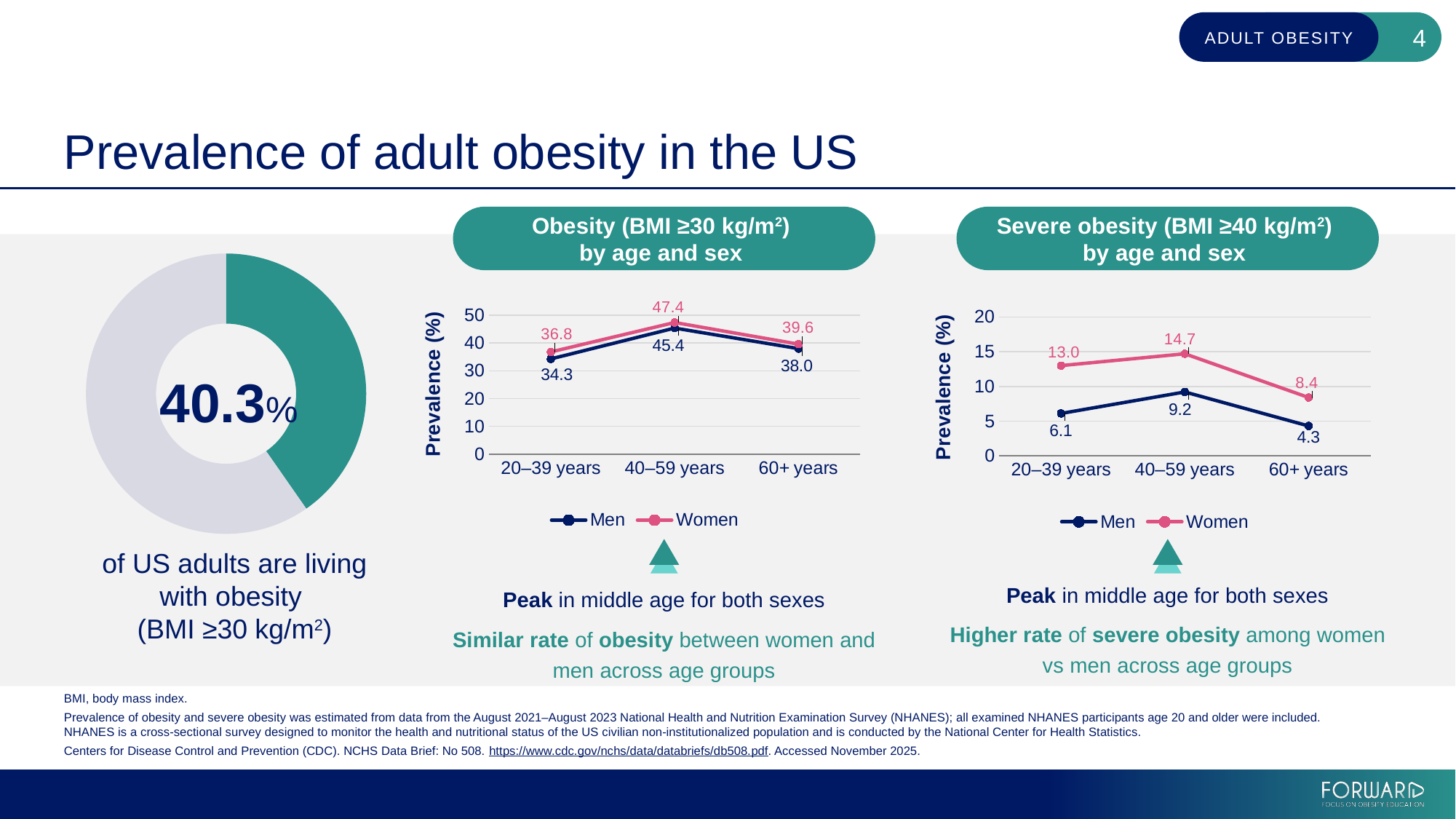
How many series does the legend of the 'Obesity (BMI ≥30 kg/m²) by age and sex' chart list? 2 In the 'Severe obesity (BMI ≥40 kg/m²) by age and sex' chart, what is the prevalence for women aged 20–39 years? 13.0 In the 'Obesity (BMI ≥30 kg/m²) by age and sex' chart, what is the prevalence for men aged 20–39 years? 34.3 In the 'Severe obesity (BMI ≥40 kg/m²) by age and sex' chart, how does the prevalence for men change from 40–59 years to 60+ years? It falls In the 'Obesity (BMI ≥30 kg/m²) by age and sex' chart, what is the difference between women and men aged 60+ years? 1.6 In the donut chart on the left of the slide, what share of US adults are living with obesity? 40.3% In the 'Severe obesity (BMI ≥40 kg/m²) by age and sex' chart, which is larger: women aged 60+ years or men aged 60+ years? Women aged 60+ years In the 'Obesity (BMI ≥30 kg/m²) by age and sex' chart, which age group has the highest prevalence for men? 40–59 years In the 'Obesity (BMI ≥30 kg/m²) by age and sex' chart, what is the prevalence for women aged 40–59 years? 47.4 In the 'Severe obesity (BMI ≥40 kg/m²) by age and sex' chart, what is the difference between women and men aged 40–59 years? 5.5 How many age groups are shown on the x axis of the 'Severe obesity (BMI ≥40 kg/m²) by age and sex' chart? 3 In the 'Severe obesity (BMI ≥40 kg/m²) by age and sex' chart, which age group has the lowest prevalence for men? 60+ years